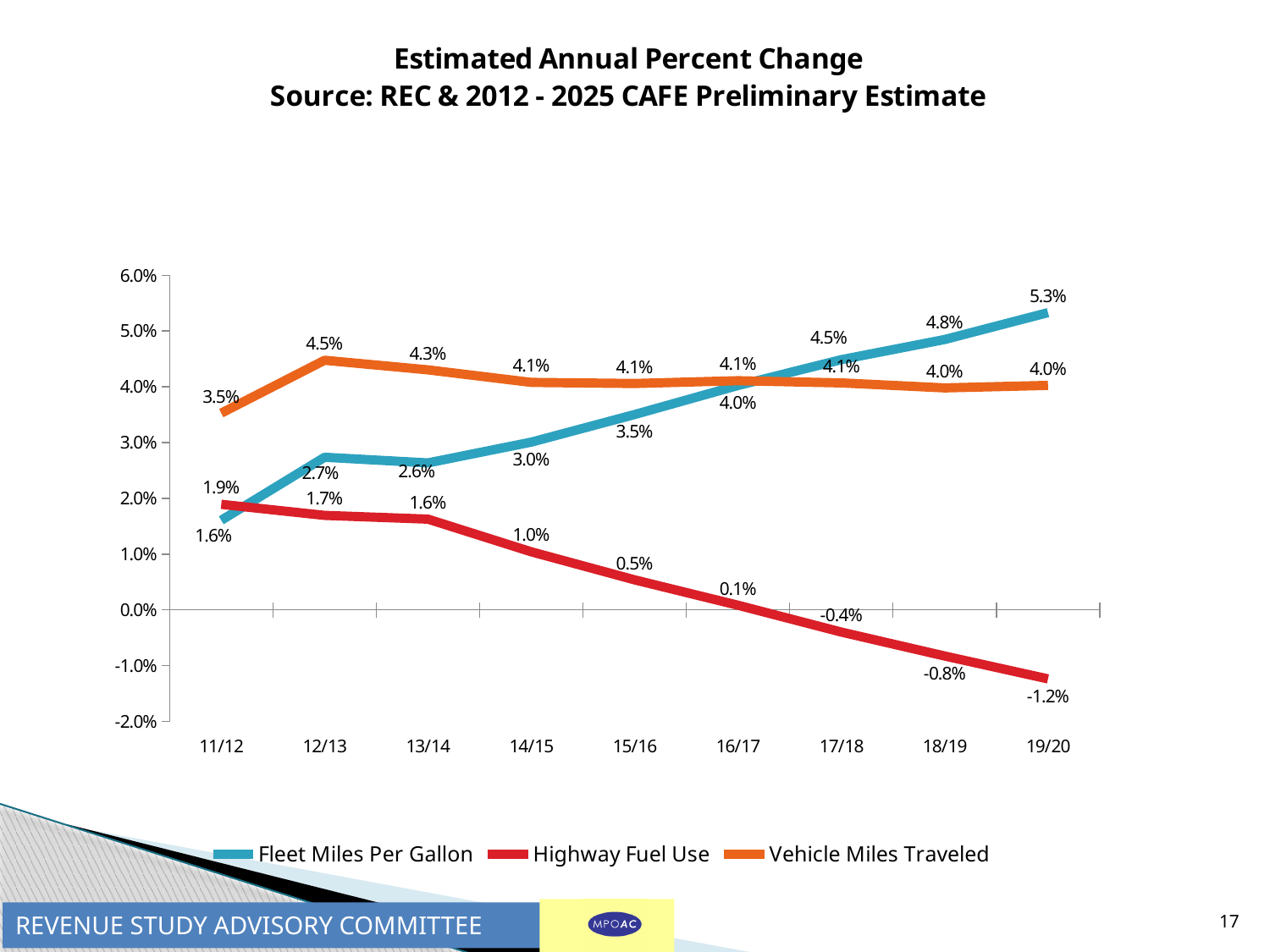
In which period is Vehicle Miles Traveled highest? 12/13 How many series does the legend list? 3 What is the difference between Fleet Miles Per Gallon and Highway Fuel Use in 19/20? 6.5% Does Highway Fuel Use rise or fall from 11/12 to 19/20? Fall What is the value for Highway Fuel Use in 16/17? 0.1% In which period is Highway Fuel Use lowest? 19/20 What type of chart is shown on the slide? Line chart Which is larger in 11/12, Fleet Miles Per Gallon or Highway Fuel Use? Highway Fuel Use What is the value for Fleet Miles Per Gallon in 19/20? 5.3% What is the value for Vehicle Miles Traveled in 12/13? 4.5% Which series is drawn in orange? Vehicle Miles Traveled How many periods are plotted along the x axis? 9